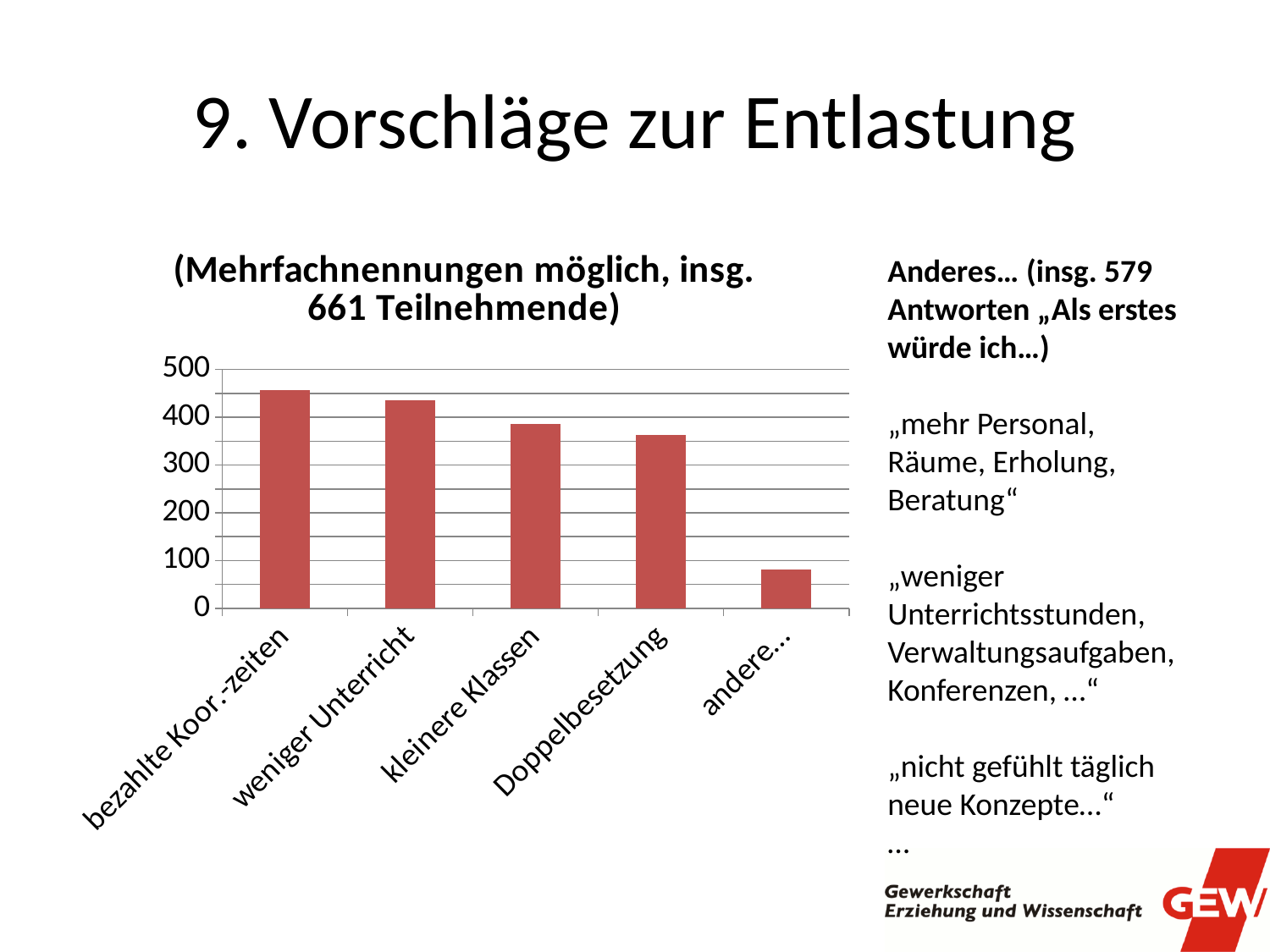
Which is larger, the value for weniger Unterricht or the value for kleinere Klassen? weniger Unterricht Is the value for Doppelbesetzung greater or less than 300? greater What is the title of the chart? (Mehrfachnennungen möglich, insg. 661 Teilnehmende) How many categories are shown on the x axis of the chart? 5 Which is larger, the value for Doppelbesetzung or the value for andere...? Doppelbesetzung Which category has the highest value in the chart? bezahlte Koor.-zeiten Is the value for andere... greater or less than 100? less Is the value for bezahlte Koor.-zeiten greater or less than 400? greater What kind of chart is shown on the slide? bar chart Do the values rise or fall from left to right along the x axis? fall Which category has the lowest value in the chart? andere...